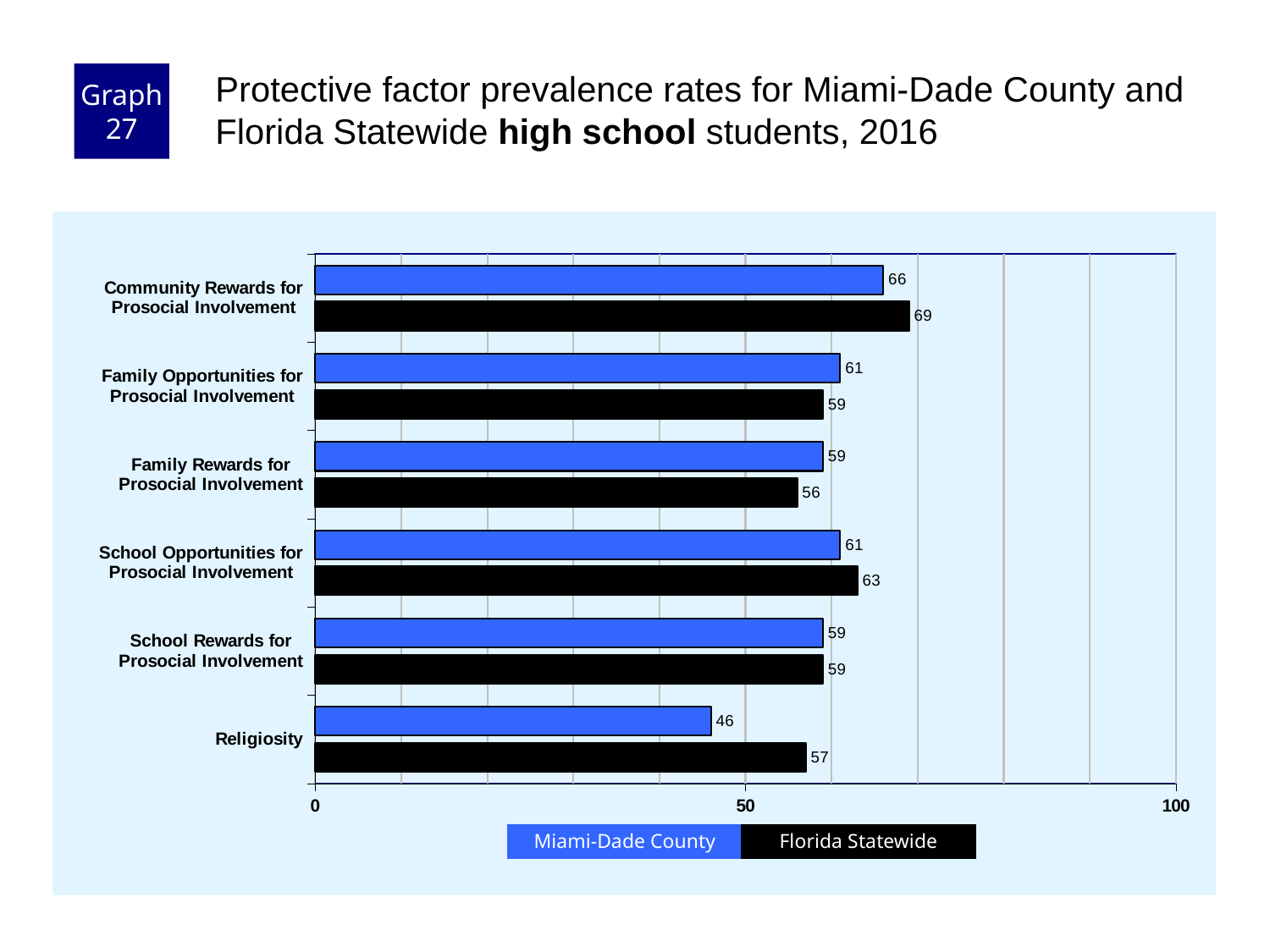
How many series does the legend list? 2 What is the difference between the Florida Statewide and Miami-Dade County values for Religiosity? 11 Which category has the highest Florida Statewide value? Community Rewards for Prosocial Involvement What is the difference between the Florida Statewide and Miami-Dade County values for Community Rewards for Prosocial Involvement? 3 Is the Miami-Dade County value for Religiosity greater or less than 50? less What is the Florida Statewide value for Family Rewards for Prosocial Involvement? 56 Which category has the lowest Miami-Dade County value? Religiosity What kind of chart is shown on the slide? bar chart How many protective factor categories are shown on the chart? 6 What is the Miami-Dade County value for Community Rewards for Prosocial Involvement? 66 For School Opportunities for Prosocial Involvement, which is larger: the Miami-Dade County value or the Florida Statewide value? Florida Statewide What is the Florida Statewide value for Religiosity? 57